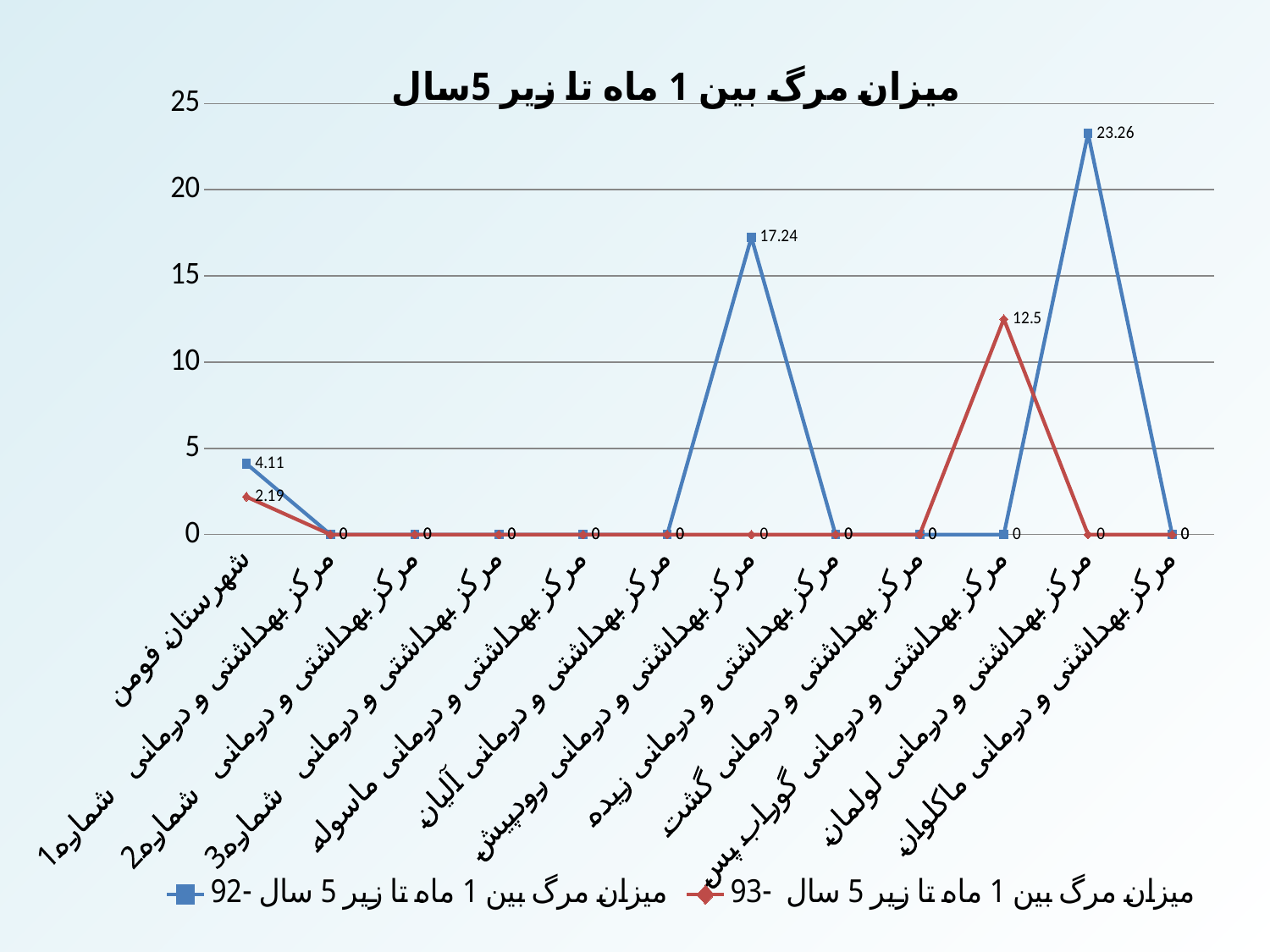
Which category has the highest value in the 92 series (blue)? مرکز بهداشتی و درمانی لولمان What is the value of the 93 series (red) for مرکز بهداشتی و درمانی گوراب پس? 12.5 Which category has the highest value in the 93 series (red)? مرکز بهداشتی و درمانی گوراب پس What is the value of the 93 series (red) for شهرستان فومن? 2.19 What type of chart is shown on the slide? line chart What is the value of the 92 series (blue) for شهرستان فومن? 4.11 What is the value of the 92 series (blue) for مرکز بهداشتی و درمانی رودپیش? 17.24 What is the title of the chart? میزان مرگ بین 1 ماه تا زیر 5سال How many series does the legend list? 2 How many categories are shown on the x axis? 12 For شهرستان فومن, which series has the larger value, 92 (blue) or 93 (red)? 92 (blue)